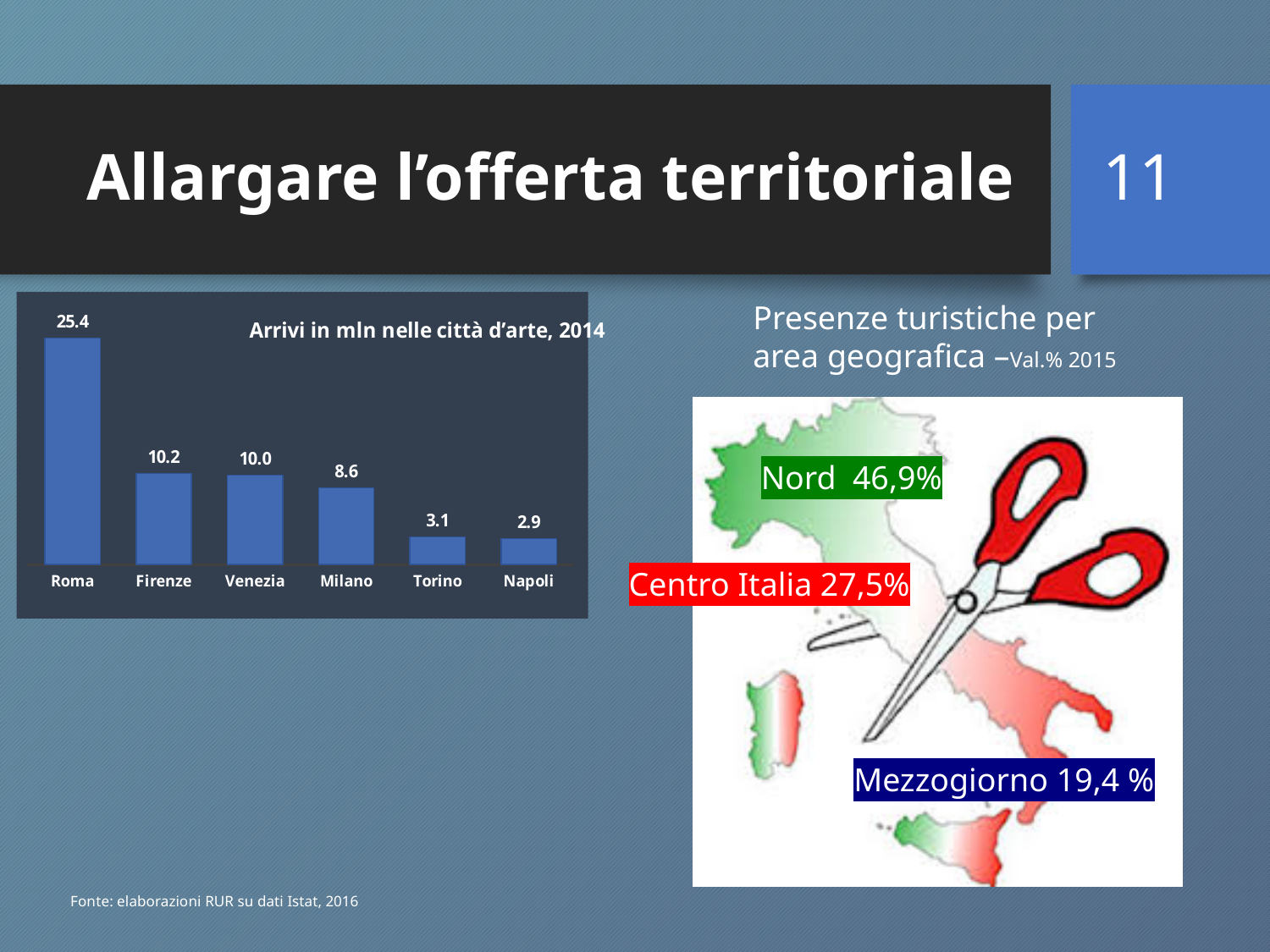
Which city has the highest value in the chart 'Arrivi in mln nelle città d'arte, 2014'? Roma How many cities are shown in the chart 'Arrivi in mln nelle città d'arte, 2014'? 6 In the chart 'Arrivi in mln nelle città d'arte, 2014', what is the difference between the values for Roma and Firenze? 15.2 Which city has the lowest value in the chart 'Arrivi in mln nelle città d'arte, 2014'? Napoli What is the value for Napoli in the chart 'Arrivi in mln nelle città d'arte, 2014'? 2.9 What is the value for Milano in the chart 'Arrivi in mln nelle città d'arte, 2014'? 8.6 What is the value for Roma in the chart 'Arrivi in mln nelle città d'arte, 2014'? 25.4 In the chart 'Arrivi in mln nelle città d'arte, 2014', what is the difference between the values for Firenze and Venezia? 0.2 Do the values in the chart 'Arrivi in mln nelle città d'arte, 2014' rise or fall from left to right? Fall What is the title of the bar chart on the left of the slide? Arrivi in mln nelle città d'arte, 2014 In the chart 'Arrivi in mln nelle città d'arte, 2014', which is larger, the value for Milano or the value for Torino? Milano What kind of chart is 'Arrivi in mln nelle città d'arte, 2014'? Bar chart